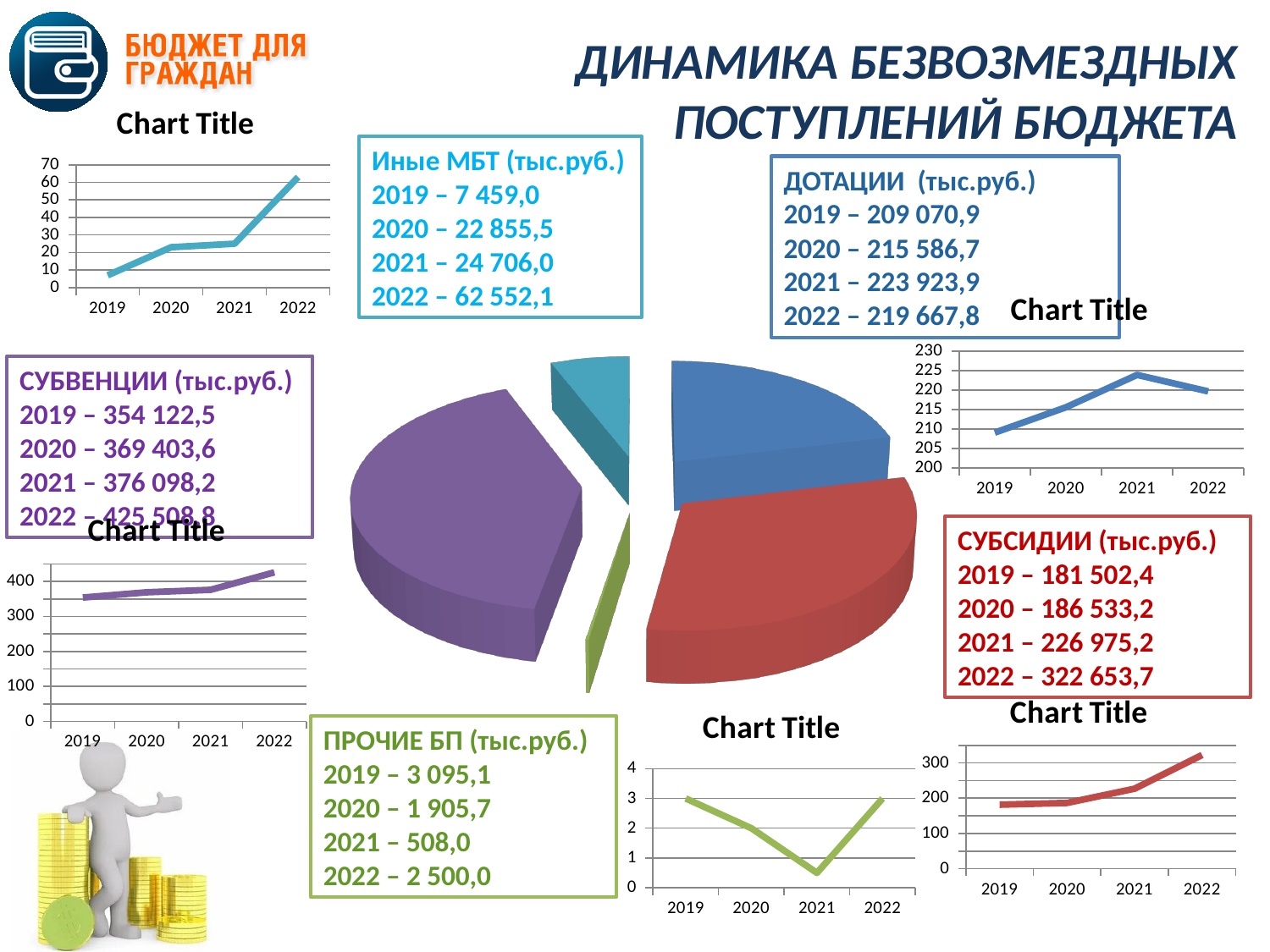
In the blue line chart on the right side of the slide (axis 200 to 230), is the value for 2019 greater or less than 215? less In the teal line chart in the top-left corner, which year has the highest value? 2022 What kind of chart is the large chart in the centre of the slide? pie chart In the blue line chart on the right side of the slide (axis 200 to 230), which year has the highest value? 2021 What kind of chart is the teal chart in the top-left corner of the slide? line chart In the red line chart in the bottom-right corner of the slide, is the value for 2022 greater or less than 300? greater In the teal line chart in the top-left corner, how many years are shown on the x axis? 4 In the purple line chart on the left side of the slide (axis 0 to 400), do the values rise or fall from 2019 to 2022? rise In the teal line chart in the top-left corner, is the value for 2019 greater or less than 20? less In the green line chart at the bottom centre of the slide (axis 0 to 4), which year has the lowest value? 2021 How many slices does the pie chart in the centre of the slide have? 5